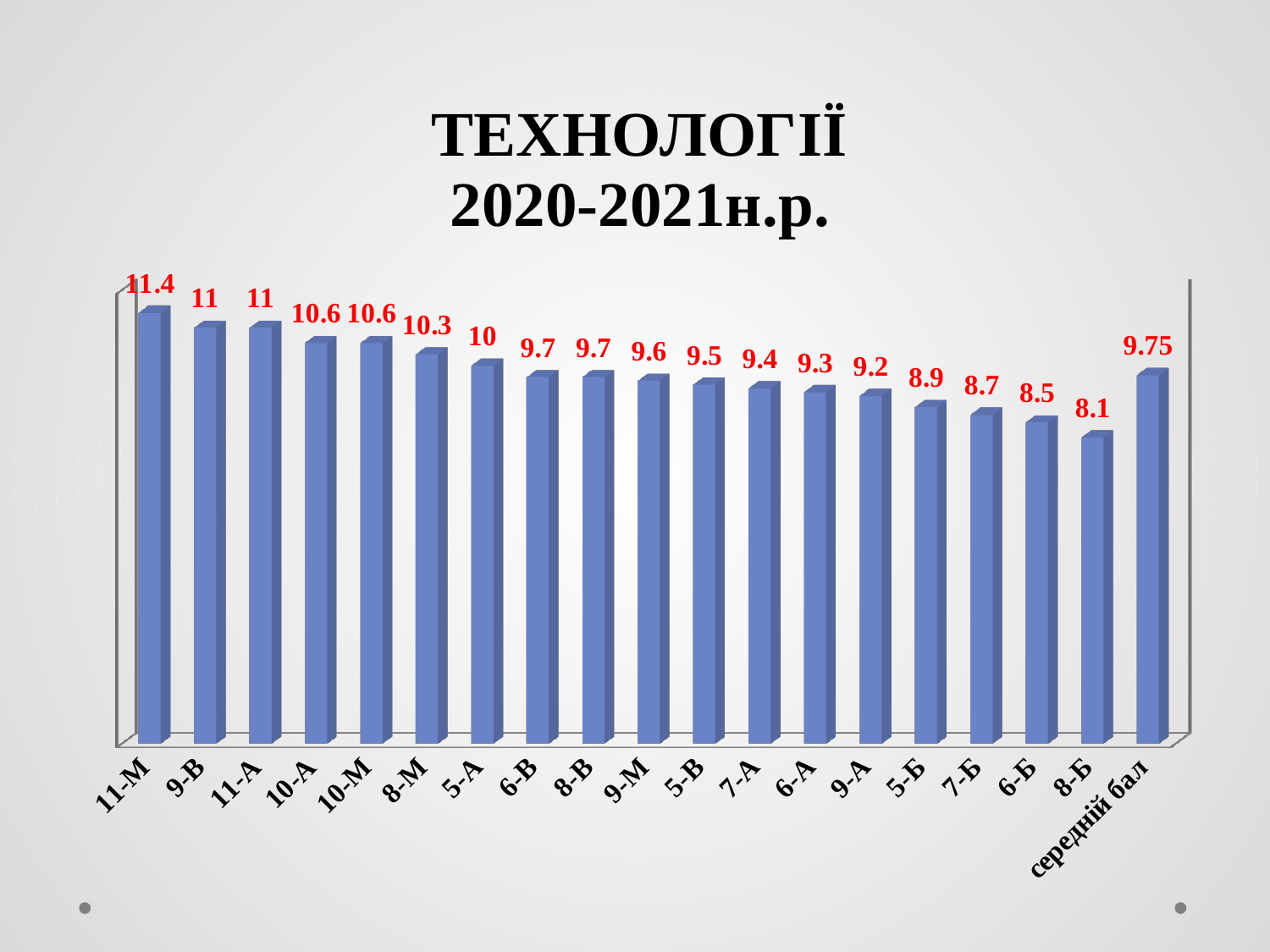
What is the value for 5-А? 10 Which is larger, the value for 9-В or the value for 7-Б? 9-В What kind of chart is shown on the slide? bar chart What is the title of the chart? ТЕХНОЛОГІЇ 2020-2021н.р. What is the value for 11-М? 11.4 How many bars are plotted in the chart? 19 What is the value for 8-Б? 8.1 What is the difference between the values for 10-А and 5-Б? 1.7 What is the difference between the values for 11-М and 8-Б? 3.3 Which category has the lowest value? 8-Б What is the value for середній бал? 9.75 Which category has the highest value? 11-М